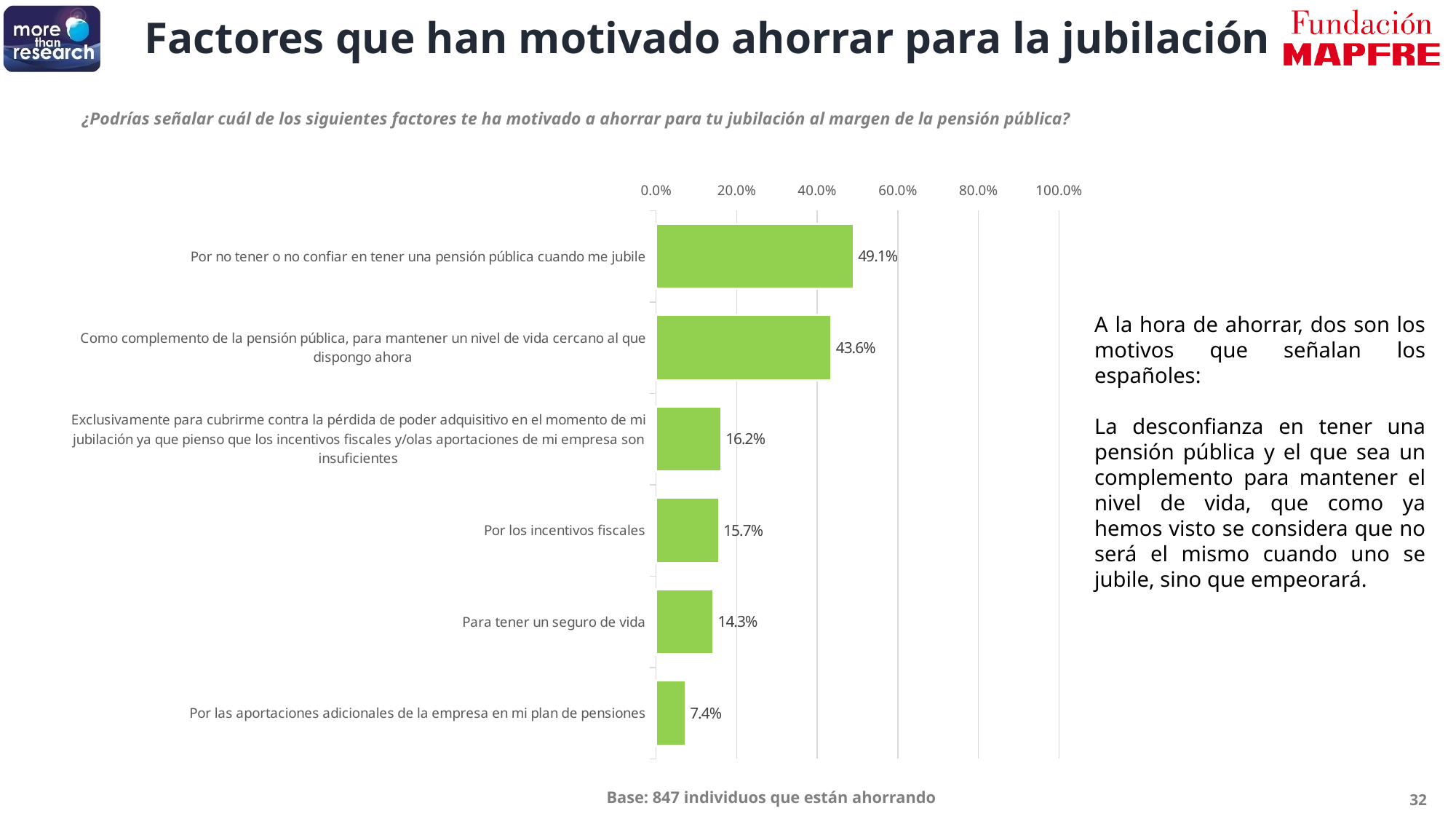
How many factors (bars) are shown in the chart? 6 Which factor has the lowest percentage? Por las aportaciones adicionales de la empresa en mi plan de pensiones What is the value shown for 'Por los incentivos fiscales'? 15.7% What percentage of respondents cite 'Por no tener o no confiar en tener una pensión pública cuando me jubile' as a motivating factor? 49.1% What type of chart is used on this slide? Bar chart What is the base (number of individuals) stated below the chart? 847 individuos que están ahorrando What is the value shown for 'Por las aportaciones adicionales de la empresa en mi plan de pensiones'? 7.4% What is the value shown for 'Para tener un seguro de vida'? 14.3% What is the difference in percentage points between the top factor (49.1%) and 'Como complemento de la pensión pública...' (43.6%)? 5.5 percentage points Which is larger: the value for 'Por los incentivos fiscales' or the value for 'Para tener un seguro de vida'? Por los incentivos fiscales Is the value for 'Como complemento de la pensión pública, para mantener un nivel de vida cercano al que dispongo ahora' greater or less than 40.0%? greater Which factor has the highest percentage? Por no tener o no confiar en tener una pensión pública cuando me jubile